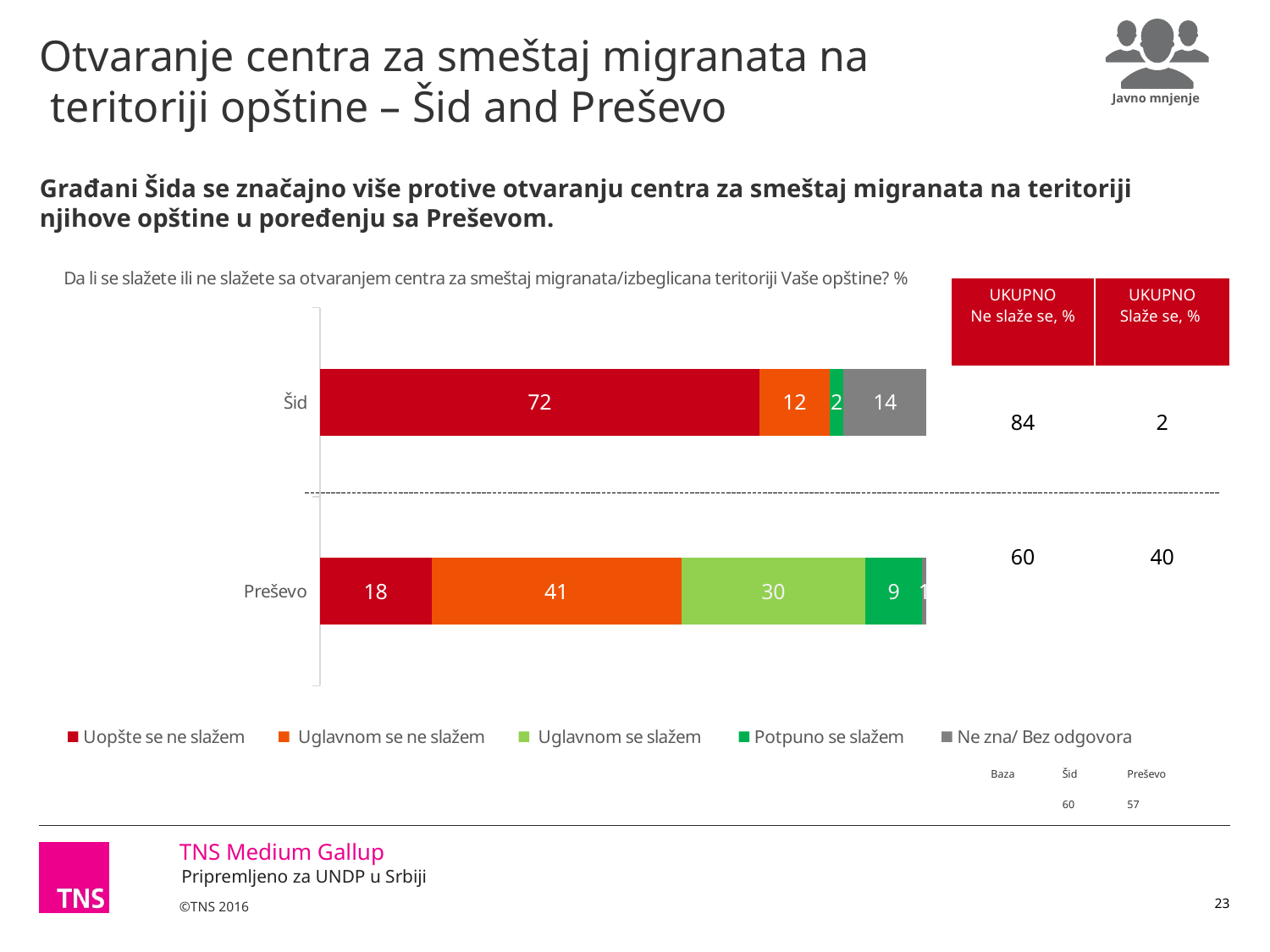
According to the 'UKUPNO Ne slaže se, %' column, what is the value for Šid? 84 What is the value for 'Uglavnom se ne slažem' for Preševo? 41 According to the 'UKUPNO Slaže se, %' column, what is the value for Preševo? 40 How many categories (municipalities) are plotted in the chart? 2 What is the value for 'Uopšte se ne slažem' for Šid? 72 Which municipality has the higher value for 'Uopšte se ne slažem', Šid or Preševo? Šid What is the value for 'Potpuno se slažem' for Preševo? 9 What is the value for 'Ne zna/ Bez odgovora' for Šid? 14 How many series does the legend list? 5 What is the difference between the 'Uopšte se ne slažem' values for Šid and Preševo? 54 What kind of chart is shown on the slide? Stacked bar chart What is the value for 'Uglavnom se slažem' for Preševo? 30